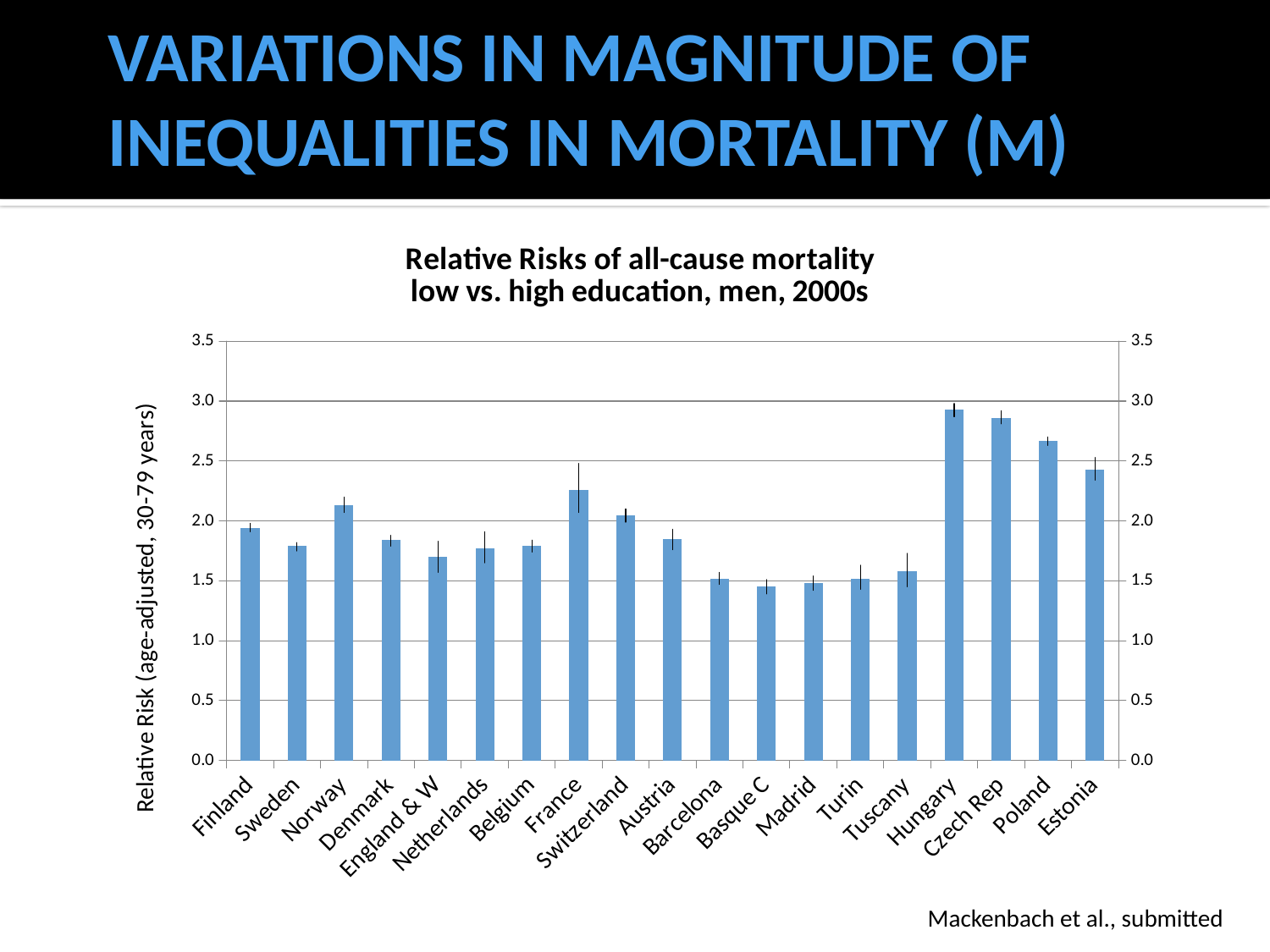
How many countries or regions are plotted on the x axis of the chart? 19 Is the relative risk for France greater or less than 2.0? greater Which country or region has the highest relative risk in the chart? Hungary Is the relative risk for Estonia greater or less than 2.5? less Is the relative risk for Hungary greater or less than 2.5? greater Which has the larger relative risk, Poland or Estonia? Poland What is the label on the vertical axis of the chart? Relative Risk (age-adjusted, 30-79 years) Which has the larger relative risk, France or Switzerland? France What kind of chart is shown on the slide? bar chart What is the title of the chart? Relative Risks of all-cause mortality low vs. high education, men, 2000s